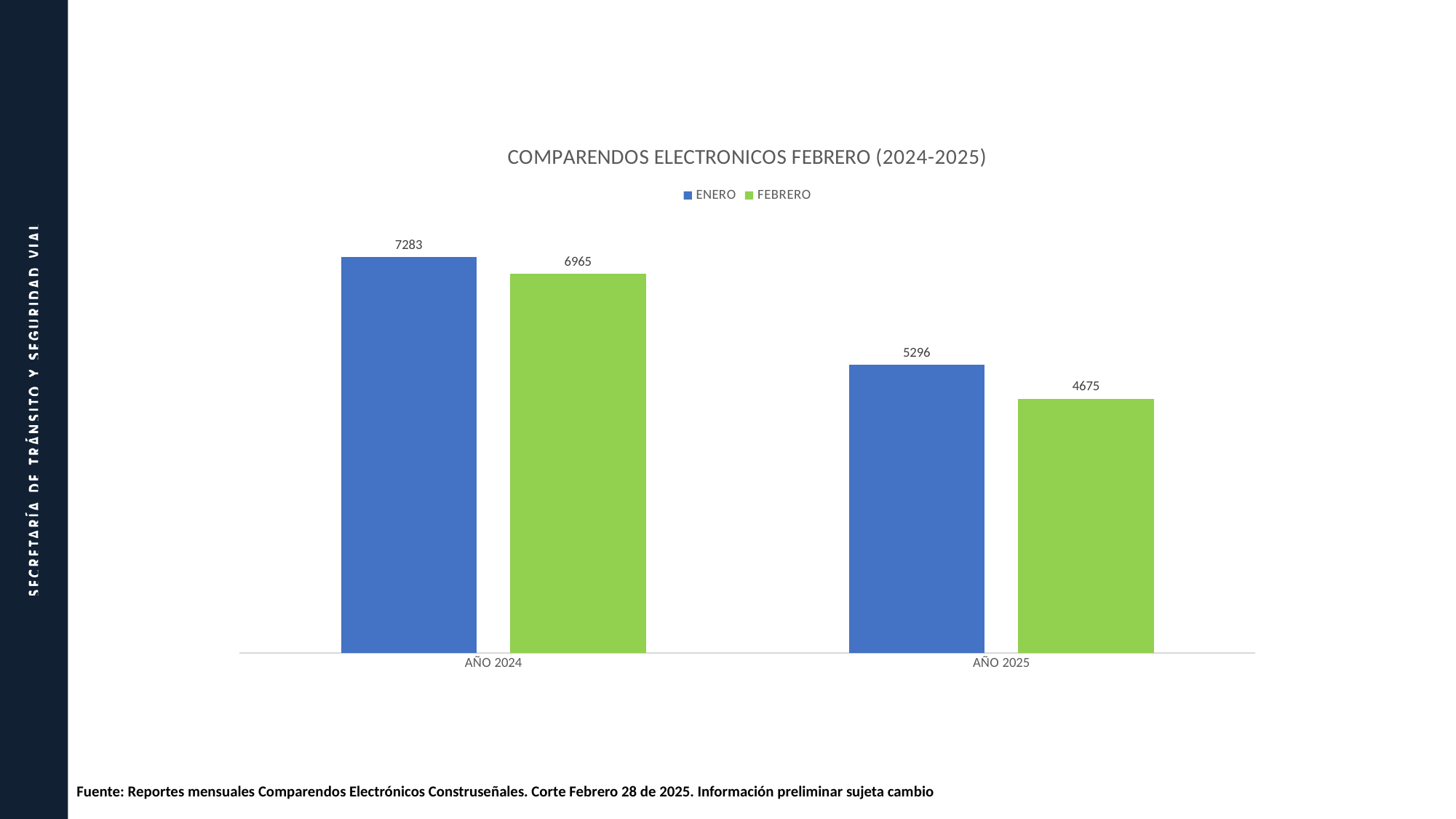
What is the difference between the ENERO values for AÑO 2024 and AÑO 2025? 1987 What kind of chart is shown on the slide? Bar chart How many series does the legend list? 2 What is the difference between ENERO and FEBRERO in AÑO 2025? 621 What is the value for FEBRERO in AÑO 2025? 4675 Which is larger, FEBRERO in AÑO 2024 or ENERO in AÑO 2025? FEBRERO in AÑO 2024 How many categories are shown on the x axis? 2 What is the title of the chart? COMPARENDOS ELECTRONICOS FEBRERO (2024-2025) What is the value for ENERO in AÑO 2024? 7283 Which year has the highest ENERO value? AÑO 2024 Which bar has the lowest value on the chart? FEBRERO, AÑO 2025 What is the value for FEBRERO in AÑO 2024? 6965